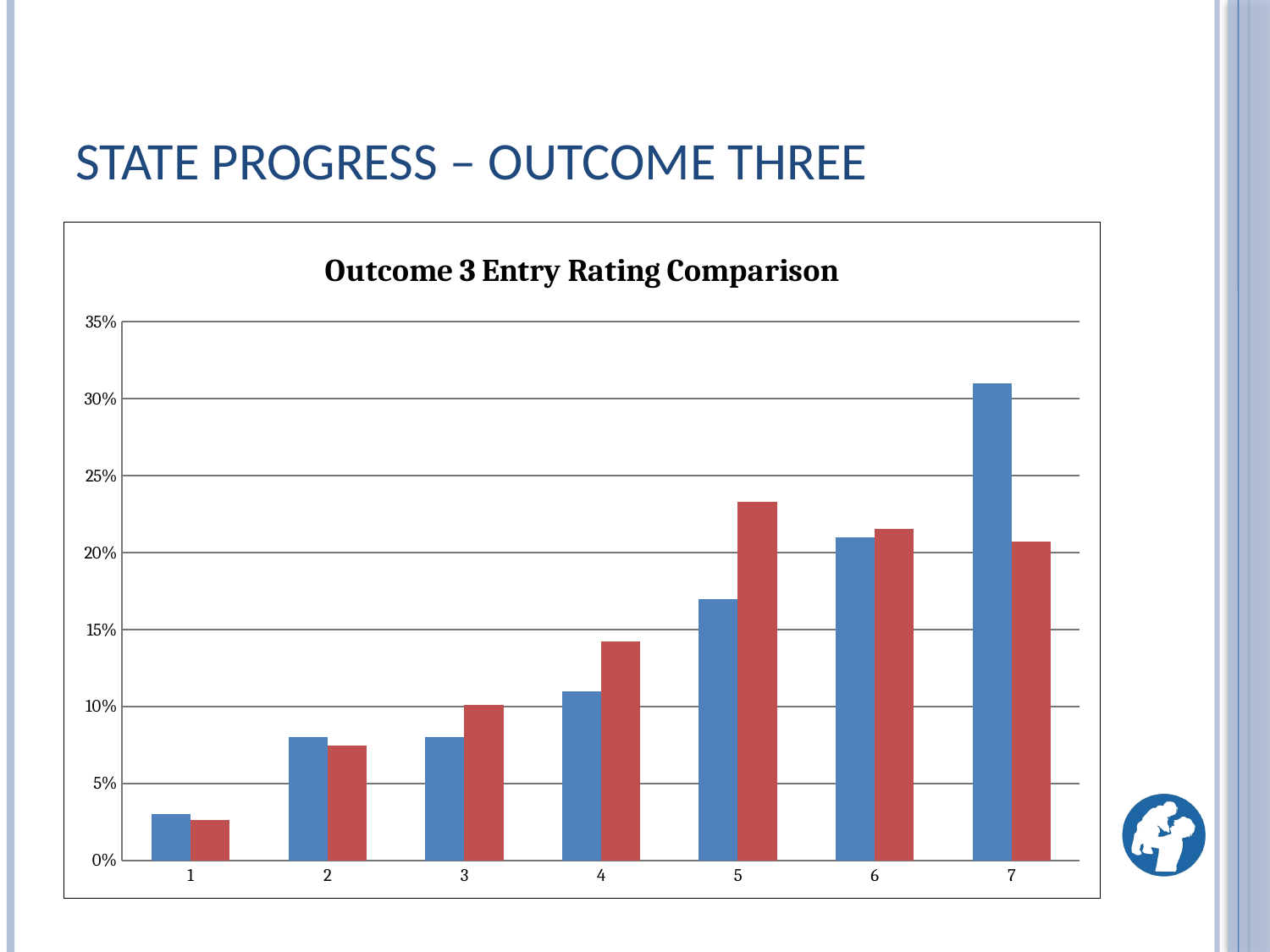
For which category is the blue bar the shortest? 1 Do the blue bars generally rise or fall from category 1 to category 7? rise How many categories are shown on the x axis of the chart? 7 Is the red bar for category 5 greater or less than 20%? greater What two colours are used for the bars in the chart? blue and red For which category is the blue bar the tallest? 7 Is the blue bar for category 7 greater or less than 25%? greater What is the title of the chart? Outcome 3 Entry Rating Comparison Is the blue bar for category 4 greater or less than 15%? less What kind of chart is shown on the slide? bar chart For which category is the red bar the tallest? 5 For category 7, which bar is taller, the blue bar or the red bar? blue